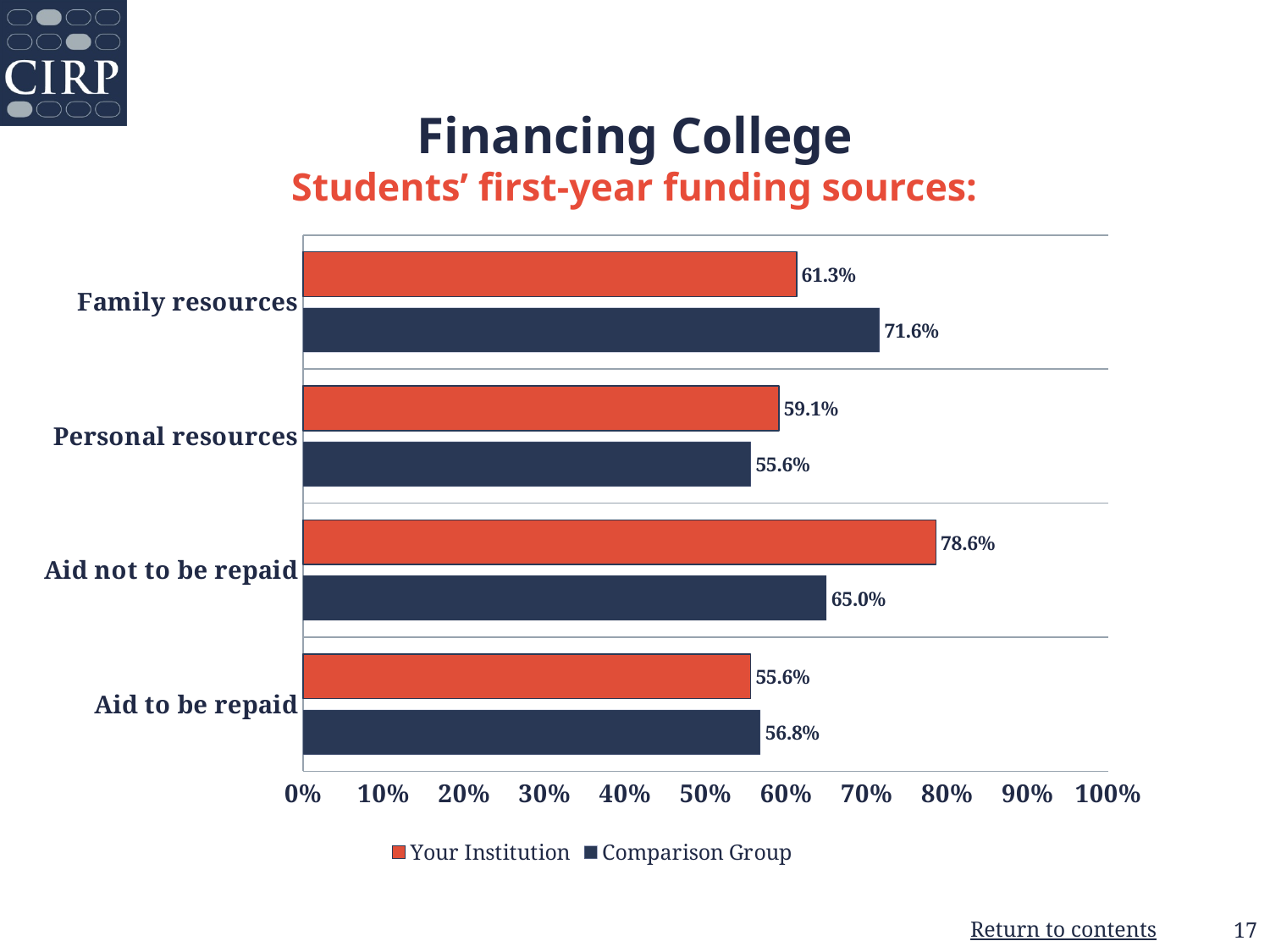
How many funding source categories are shown on the chart? 4 What is the difference between Your Institution and Comparison Group for Aid not to be repaid? 13.6% What kind of chart is shown on the slide? Bar chart What is the value for Comparison Group for Personal resources? 55.6% What is the value for Your Institution for Family resources? 61.3% What is the value for Comparison Group for Aid not to be repaid? 65.0% For Aid to be repaid, which is larger: Your Institution or Comparison Group? Comparison Group What is the difference between the Comparison Group and Your Institution values for Family resources? 10.3% Which category has the highest value for Your Institution? Aid not to be repaid How many series does the legend list? 2 Is the Your Institution value for Aid not to be repaid greater or less than 70%? greater Which category has the lowest value for Comparison Group? Personal resources